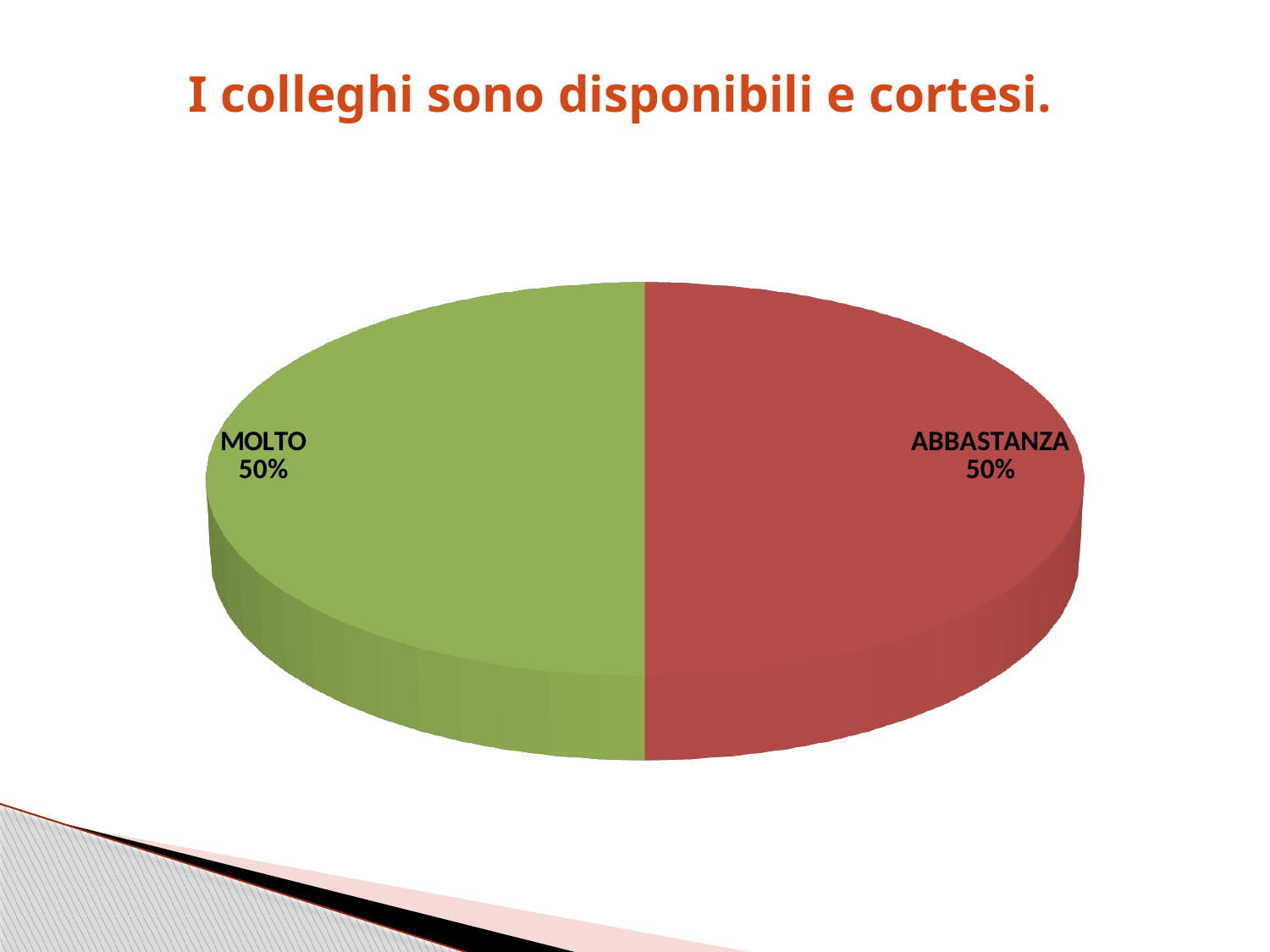
What colour is the MOLTO slice? green What is the difference between the MOLTO and ABBASTANZA shares? 0% What is the title of the slide? I colleghi sono disponibili e cortesi. What share of the pie does the MOLTO slice represent? 50% What share of the pie does the ABBASTANZA slice represent? 50% How many slices does the pie chart have? 2 What is the combined share of the MOLTO and ABBASTANZA slices? 100% What kind of chart is shown on the slide? pie chart